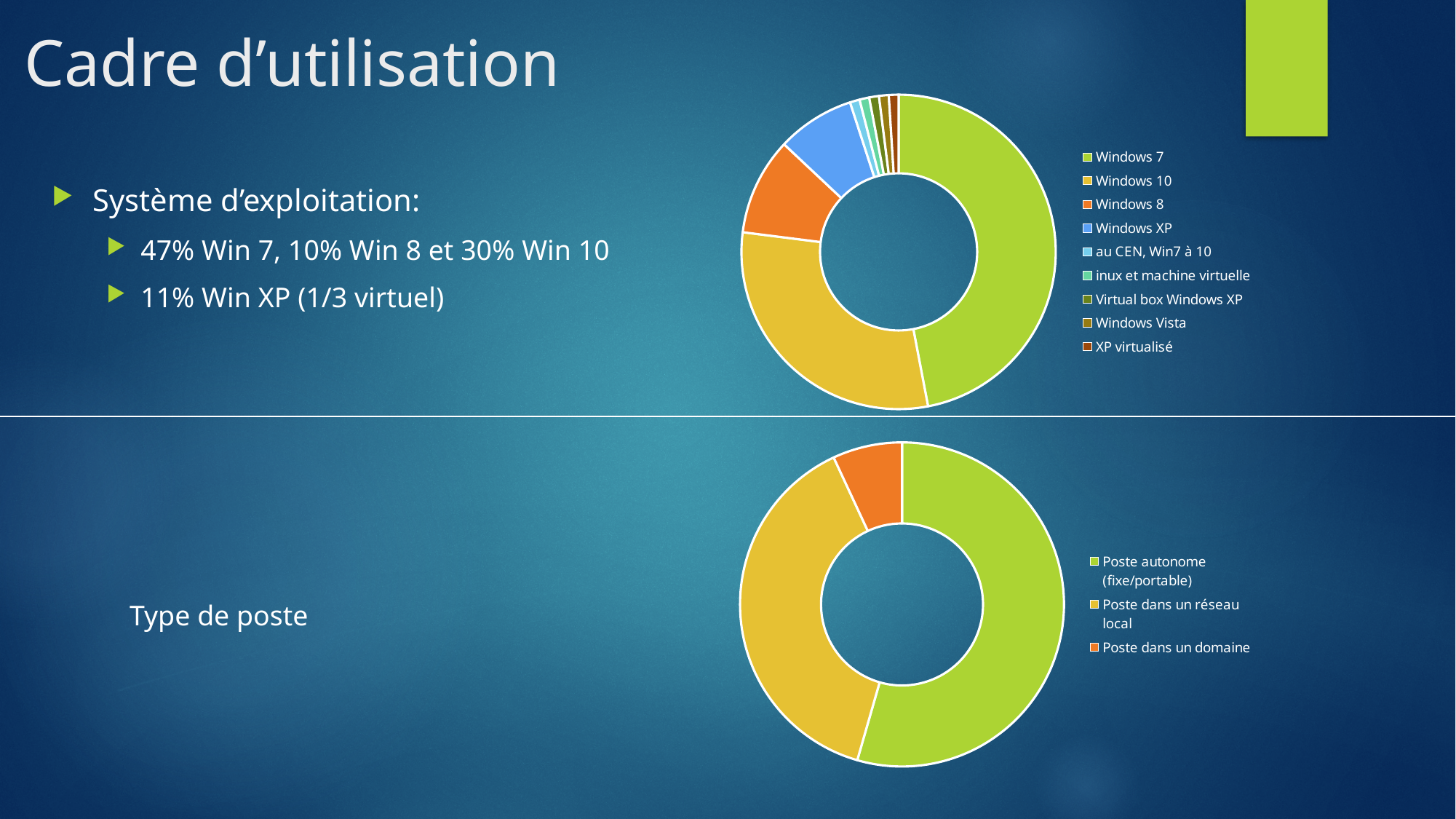
How many categories does the bottom chart (Type de poste) have? 3 What kind of chart is the top chart showing operating systems? doughnut chart In the top chart (operating systems), what colour is the Windows XP slice? light blue In the bottom chart (Type de poste), which slice is larger: Poste dans un réseau local or Poste dans un domaine? Poste dans un réseau local In the top chart (operating systems), which slice is larger: Windows 7 or Windows 10? Windows 7 In the bottom chart (Type de poste), which category has the largest slice? Poste autonome (fixe/portable) In the bottom chart (Type de poste), which category has the smallest slice? Poste dans un domaine In the top chart (operating systems), which slice is larger: Windows 10 or Windows 8? Windows 10 According to the slide, what share of the top chart (operating systems) is Windows 7? 47% According to the slide, what share of the top chart (operating systems) is Windows 10? 30% How many entries does the legend of the top chart (operating systems) list? 9 In the top chart (operating systems), which category has the largest slice? Windows 7